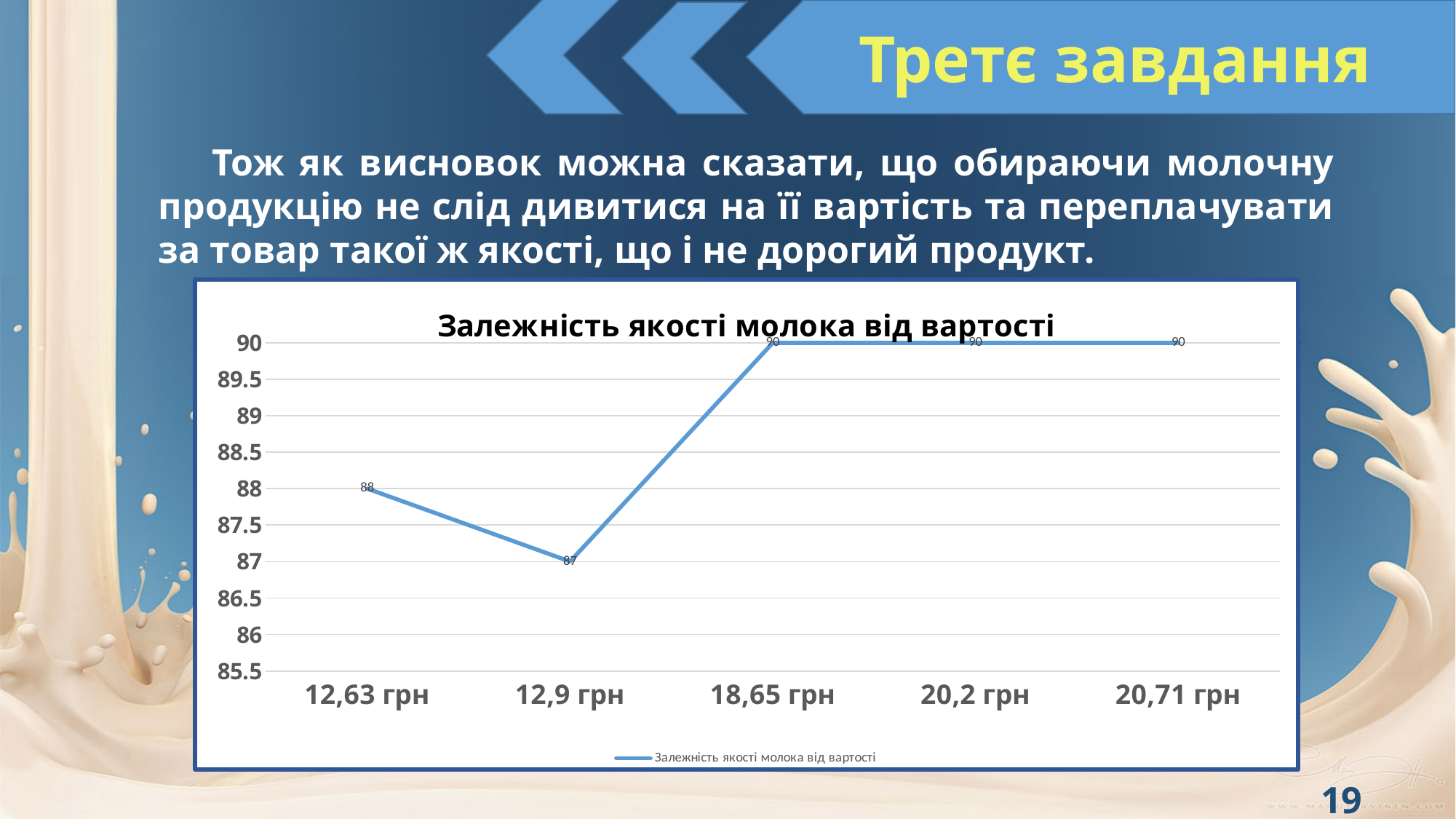
What is the value for 12,9 грн? 87 What is the difference between the values for 12,63 грн and 12,9 грн? 1 What is the value for 20,71 грн? 90 What is the value for 12,63 грн? 88 Which category has the lowest value? 12,9 грн Which is larger, the value for 12,63 грн or the value for 12,9 грн? 12,63 грн What is the title of the chart? Залежність якості молока від вартості What is the value for 18,65 грн? 90 What kind of chart is shown on the slide? line chart What is the difference between the values for 18,65 грн and 12,9 грн? 3 How many categories are shown on the x axis? 5 How many series does the legend list? 1